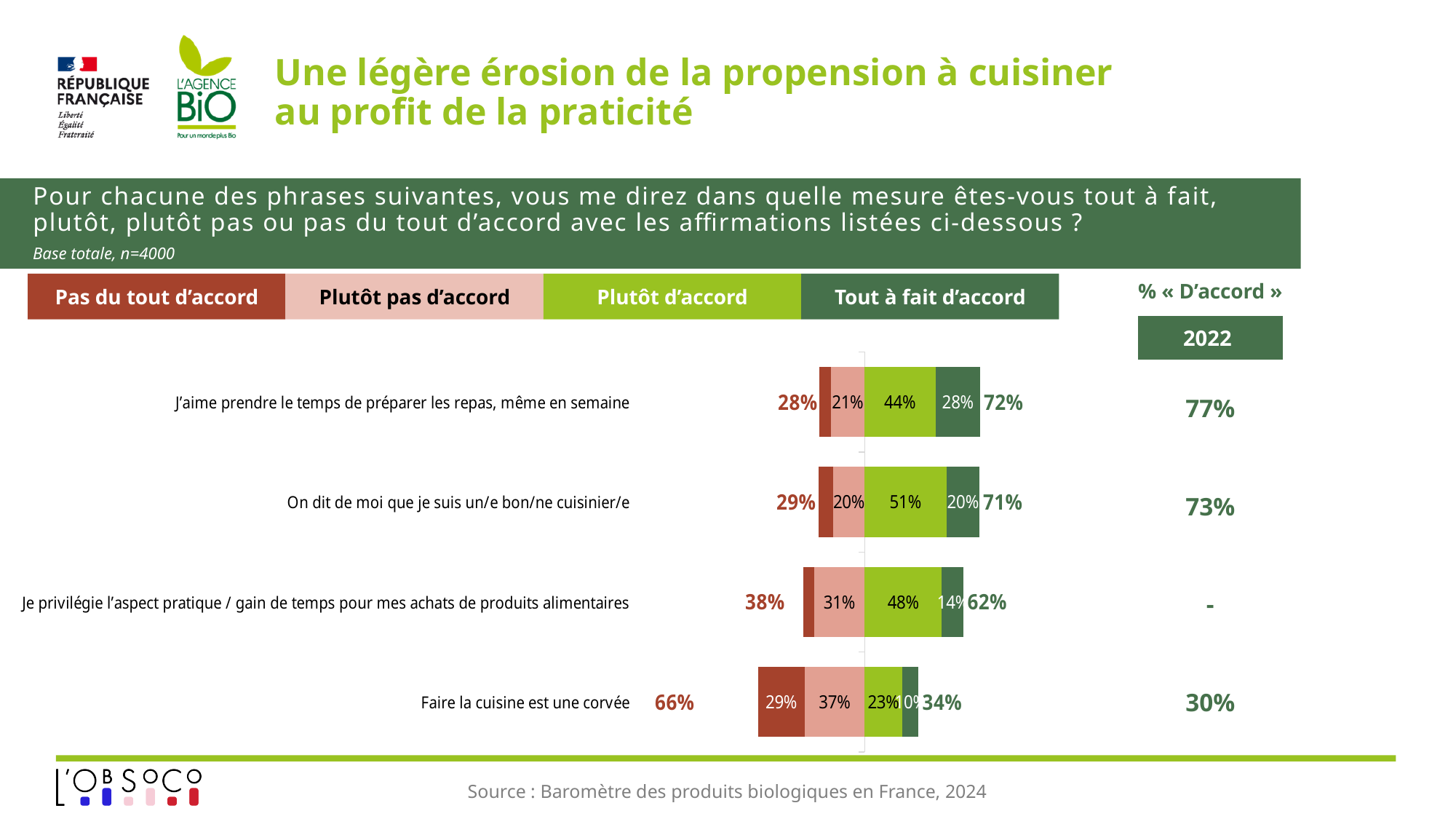
How many response categories does the legend list? 4 By how many percentage points did total agreement with 'J'aime prendre le temps de préparer les repas, même en semaine' change between 2022 (77%) and the current 72%? 5 points lower Which statement has the highest total agreement (% d'accord)? J'aime prendre le temps de préparer les repas, même en semaine What is the total '% D'accord' for 'Faire la cuisine est une corvée'? 34% What is the 'Plutôt pas d'accord' value for 'Je privilégie l'aspect pratique / gain de temps pour mes achats de produits alimentaires'? 31% Which colour represents 'Tout à fait d'accord' in the chart? dark green Which is larger for 'Faire la cuisine est une corvée': the 'Pas du tout d'accord' share or the 'Plutôt pas d'accord' share? Plutôt pas d'accord (37%) What type of chart is shown on the slide? stacked bar chart What percentage of respondents answered 'Plutôt d'accord' to 'On dit de moi que je suis un/e bon/ne cuisinier/e'? 51% Which statement has the lowest total agreement (% d'accord)? Faire la cuisine est une corvée What was the 2022 '% D'accord' value for 'J'aime prendre le temps de préparer les repas, même en semaine'? 77% How many statements (categories) are plotted in the chart? 4